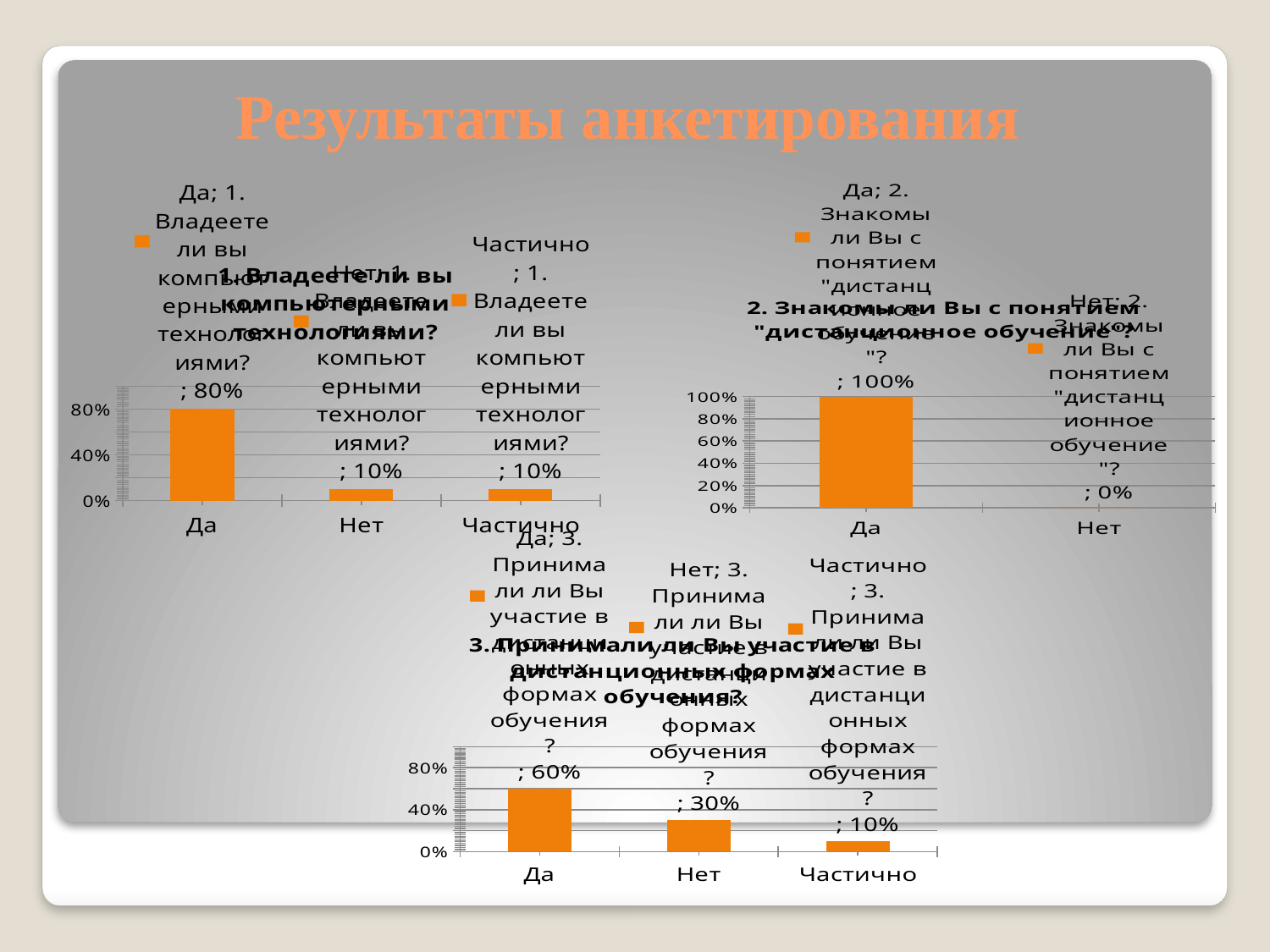
In the top-left chart (question 1), which category has the highest value? Да In the top-left chart (question 1), what is the value for "Частично"? 10% In the top-right chart (question 2, about the concept of distance learning), what is the value for "Да"? 100% In the bottom chart (question 3, about participation in distance learning), what is the value for "Нет"? 30% How many categories are shown in the top-right chart (question 2)? 2 In the top-right chart (question 2), what is the value for "Нет"? 0% In the bottom chart (question 3), which category has the lowest value? Частично In the bottom chart (question 3), which is larger, the value for "Да" or the value for "Нет"? Да How many categories are shown in the top-left chart (question 1)? 3 In the top-left chart (question 1, about computer technologies), what is the value for "Да"? 80% In the top-left chart (question 1), what is the difference between the values for "Да" and "Нет"? 70% What type of chart is the bottom chart (question 3)? Bar chart